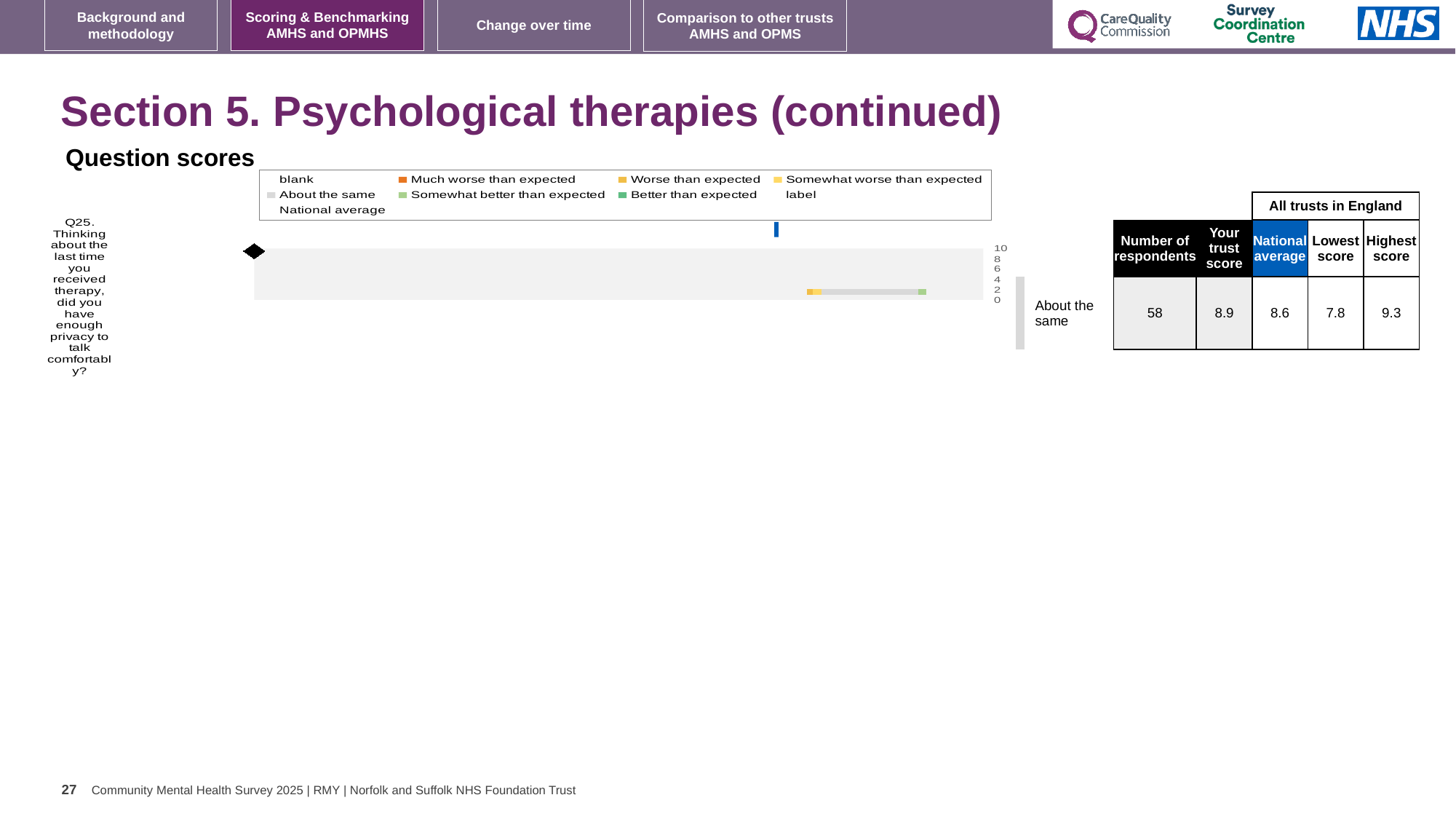
What kind of chart is shown under 'Question scores'? bar chart In the table next to the chart, what is the number of respondents for Q25? 58 For Q25, what is the difference between your trust score and the national average? 0.3 In the table next to the chart, what is 'Your trust score' for Q25? 8.9 For Q25, which is larger: your trust score or the national average? Your trust score In the table next to the chart, what is the lowest score among all trusts in England for Q25? 7.8 Is your trust score for Q25 greater or less than 8? greater In the chart legend, what colour is the marker for 'Much worse than expected'? orange In the table next to the chart, what is the national average for Q25? 8.6 In the table next to the chart, what is the highest score among all trusts in England for Q25? 9.3 What benchmark category label is shown to the right of the Q25 bar? About the same For Q25, what is the difference between the highest score and the lowest score among all trusts in England? 1.5